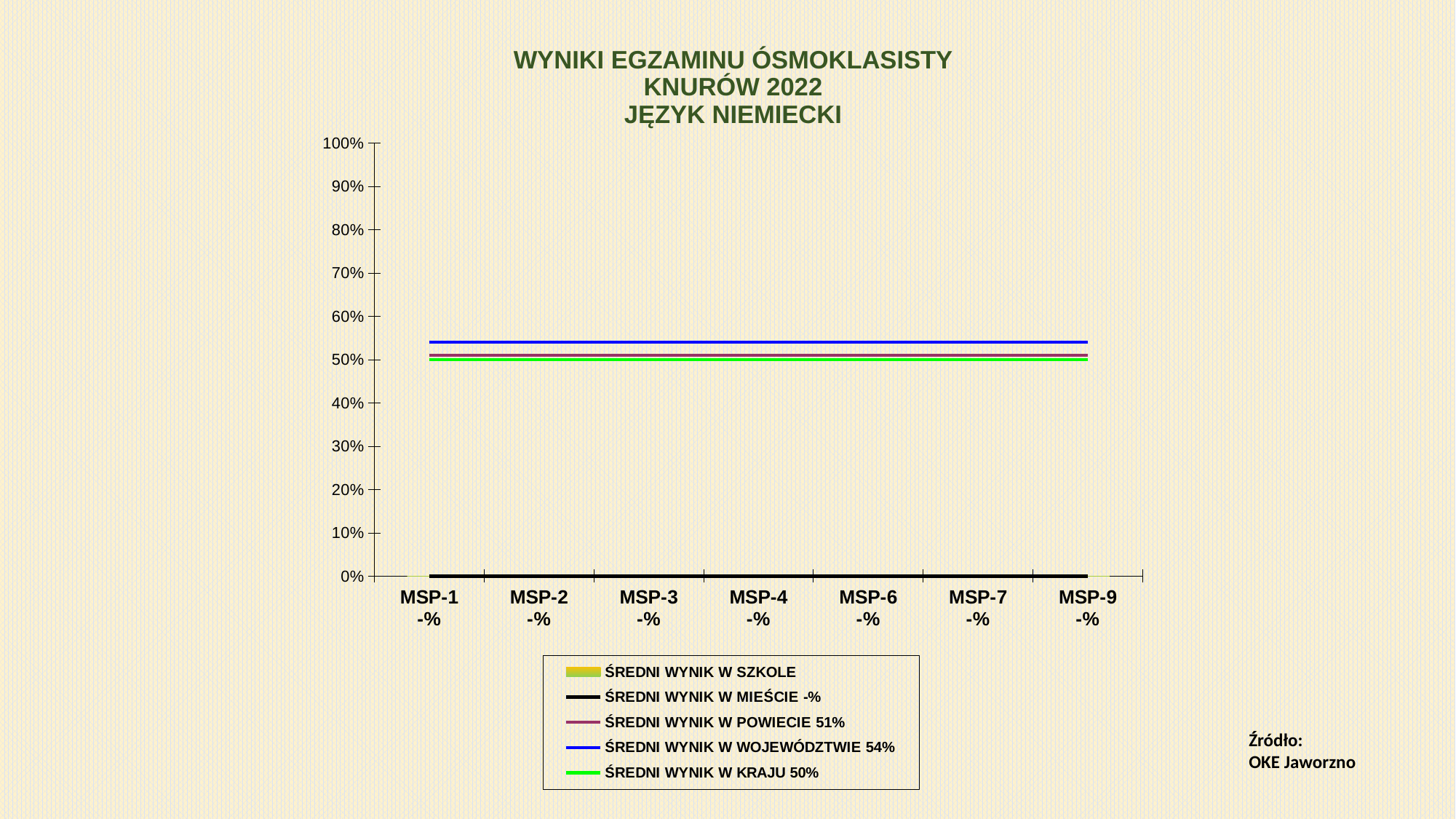
What is the average result in the country (ŚREDNI WYNIK W KRAJU) shown in the legend? 50% What is the difference between the voivodeship average (54%) and the national average (50%)? 4% What is the average result in the county (ŚREDNI WYNIK W POWIECIE) shown in the legend? 51% How many school categories (MSP) are shown on the x axis? 7 What is the average result in the voivodeship (ŚREDNI WYNIK W WOJEWÓDZTWIE) shown in the legend? 54% Which is larger, the county average or the national average? The county average (51%) Is the voivodeship average line above or below 60% on the axis? below Which of the three reference lines (powiat, województwo, kraj) has the highest value? ŚREDNI WYNIK W WOJEWÓDZTWIE What kind of chart is shown on the slide? Line chart How many series does the legend list? 5 Which subject does the chart title refer to? JĘZYK NIEMIECKI Which of the three reference lines (powiat, województwo, kraj) has the lowest value? ŚREDNI WYNIK W KRAJU